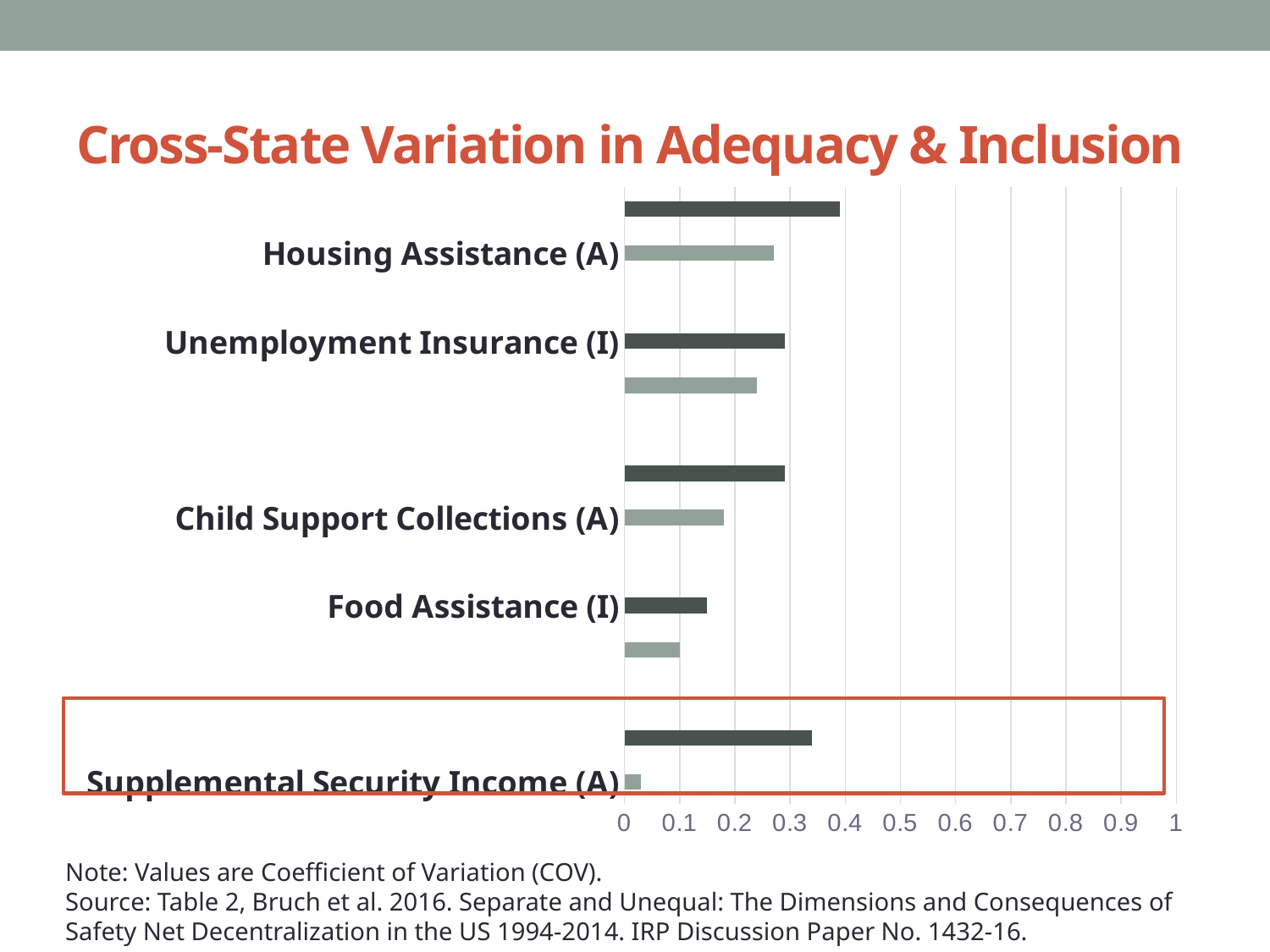
What is the title of the chart on the slide? Cross-State Variation in Adequacy & Inclusion Is the dark bar for Food Assistance (I) greater or less than 0.2? less Is the dark bar for Unemployment Insurance (I) greater or less than 0.4? less What kind of chart is shown on the slide? bar chart Is the light bar for Supplemental Security Income (A) greater or less than 0.1? less Which category has the shortest dark bar? Food Assistance (I) Which has the longer dark bar, Housing Assistance (A) or Food Assistance (I)? Housing Assistance (A) Which category has the shortest light bar? Supplemental Security Income (A) Which has the longer light bar, Food Assistance (I) or Supplemental Security Income (A)? Food Assistance (I) How many program categories are listed on the chart? 5 Which category has the longest dark bar? Housing Assistance (A)